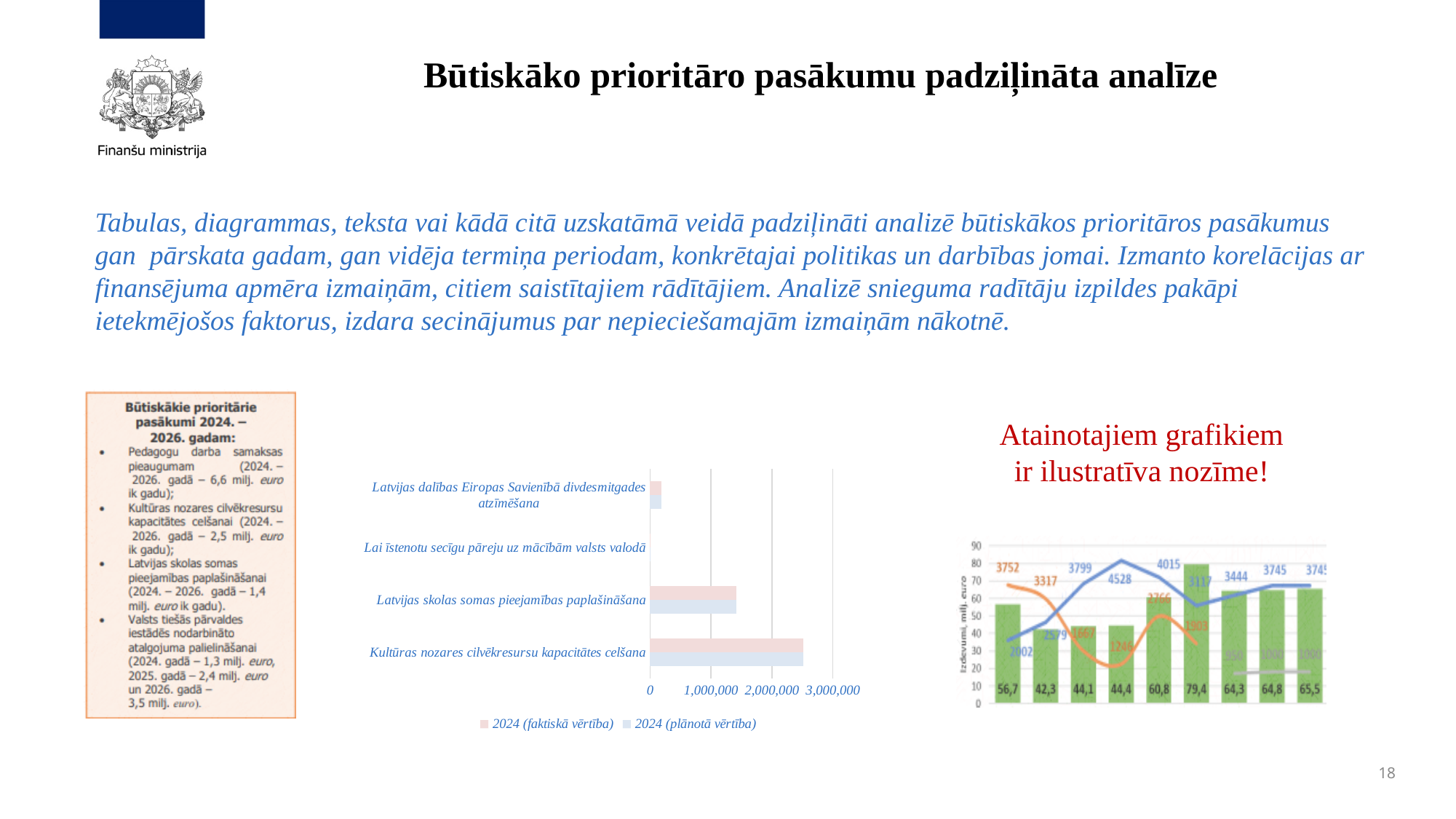
In the chart on the right, how many green bars are shown? 9 In the middle bar chart, is the 2024 (plānotā vērtība) value for 'Latvijas skolas somas pieejamības paplašināšana' greater or less than 2,000,000? less In the middle bar chart, which category has the highest values? Kultūras nozares cilvēkresursu kapacitātes celšana What kind of chart is the middle chart with the legend '2024 (faktiskā vērtība)' and '2024 (plānotā vērtība)'? bar chart In the middle bar chart, how many categories are shown on the vertical axis? 4 In the middle bar chart, how many series does the legend list? 2 In the middle bar chart, what is the first legend entry? 2024 (faktiskā vērtība) In the middle bar chart, which is larger: the 2024 (faktiskā vērtība) value for 'Kultūras nozares cilvēkresursu kapacitātes celšana' or for 'Latvijas skolas somas pieejamības paplašināšana'? Kultūras nozares cilvēkresursu kapacitātes celšana In the middle bar chart, is the 2024 (faktiskā vērtība) value for 'Kultūras nozares cilvēkresursu kapacitātes celšana' greater or less than 2,000,000? greater In the middle bar chart, is the 2024 (faktiskā vērtība) value for 'Latvijas skolas somas pieejamības paplašināšana' greater or less than 1,000,000? greater In the chart on the right, what is the highest value printed on a green bar? 79,4